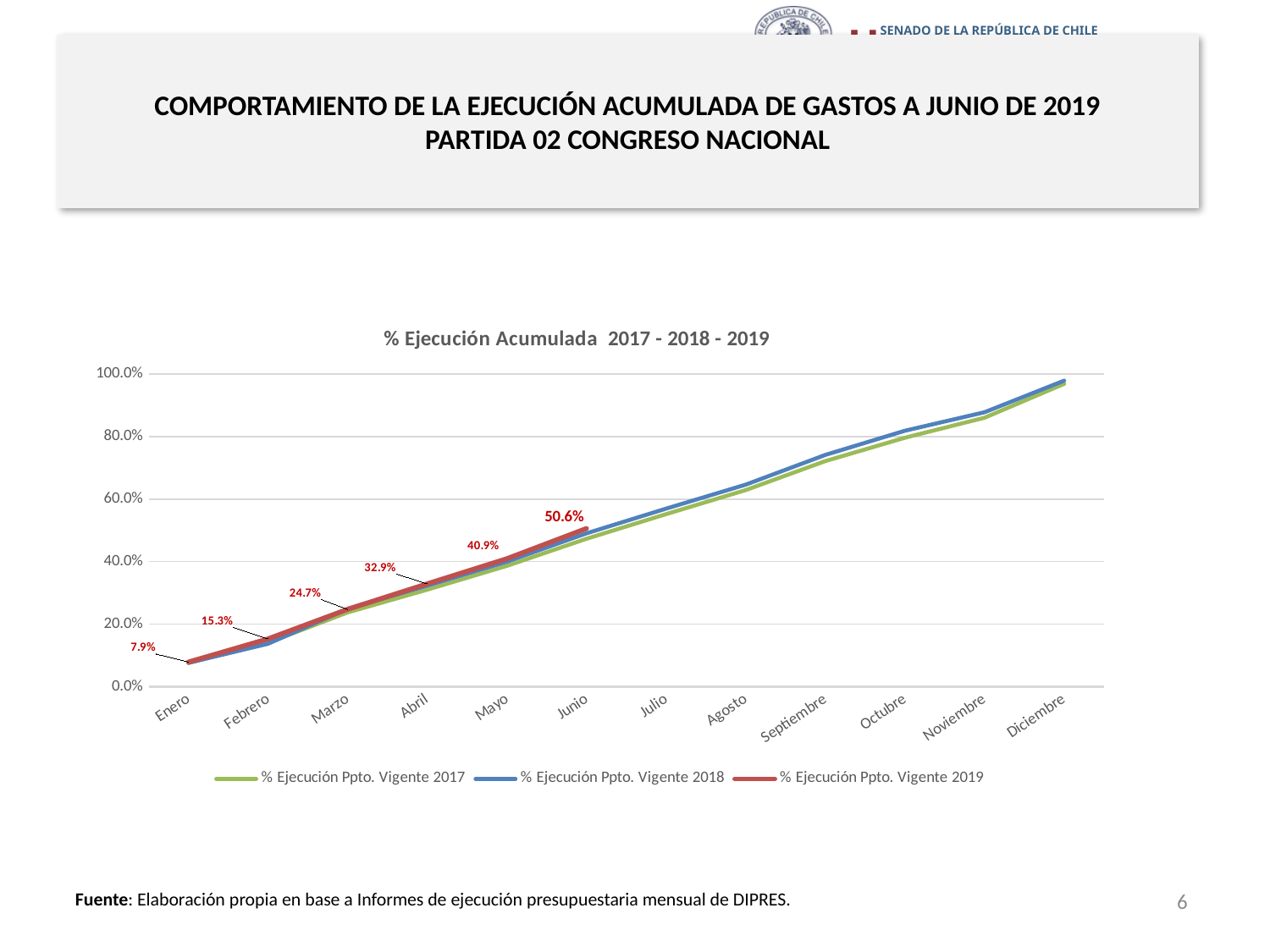
Which month has the highest labelled value for % Ejecución Ppto. Vigente 2019? Junio What is the title of the chart? % Ejecución Acumulada 2017 - 2018 - 2019 How many months are shown on the x axis? 12 What is the value of % Ejecución Ppto. Vigente 2019 for Enero? 7.9% What is the value of % Ejecución Ppto. Vigente 2019 for Junio? 50.6% How many series does the legend list? 3 What type of chart is shown on the slide? Line chart Do the values for % Ejecución Ppto. Vigente 2018 rise or fall from Enero to Diciembre? Rise Is the value for % Ejecución Ppto. Vigente 2018 in Diciembre greater or less than 80.0%? greater What is the difference between the 2019 values for Junio and Enero? 42.7 percentage points What is the value of % Ejecución Ppto. Vigente 2019 for Marzo? 24.7% What is the value of % Ejecución Ppto. Vigente 2019 for Abril? 32.9%